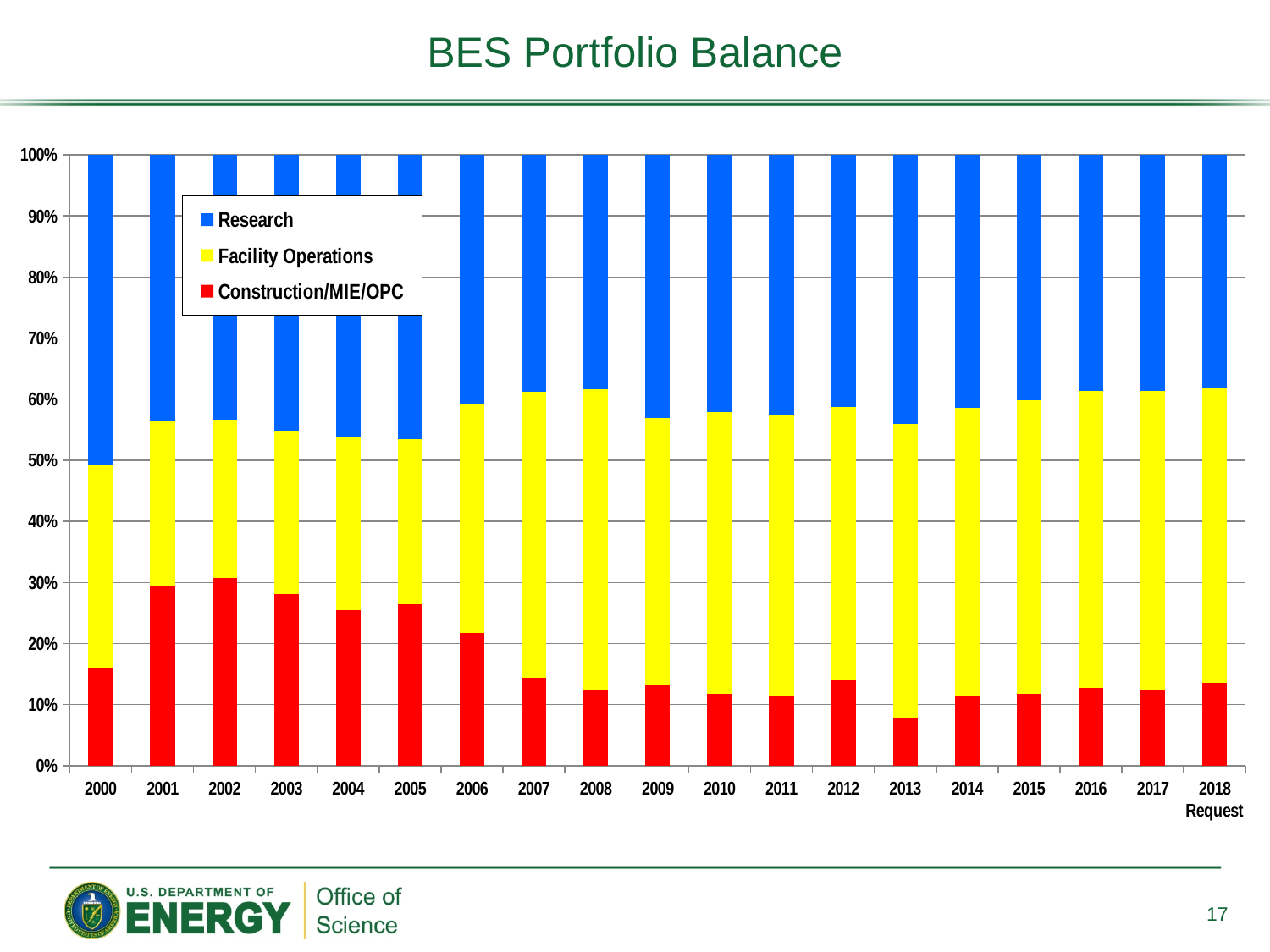
Which year has the larger Construction/MIE/OPC share, 2001 or 2013? 2001 Is the Research share for 2008 greater or less than 40%? less How many years (categories) are shown along the x axis? 19 How many series does the legend list? 3 What kind of chart is shown on the slide? stacked bar chart Which colour represents Facility Operations in the legend? yellow In which year is the Construction/MIE/OPC share lowest? 2013 What is the total of the stacked bar for 2010? 100% Does the Construction/MIE/OPC share generally rise or fall from 2002 to 2013? fall What is the title of the chart? BES Portfolio Balance Is the Construction/MIE/OPC share for 2013 greater or less than 10%? less Is the Construction/MIE/OPC share for 2002 greater or less than 20%? greater